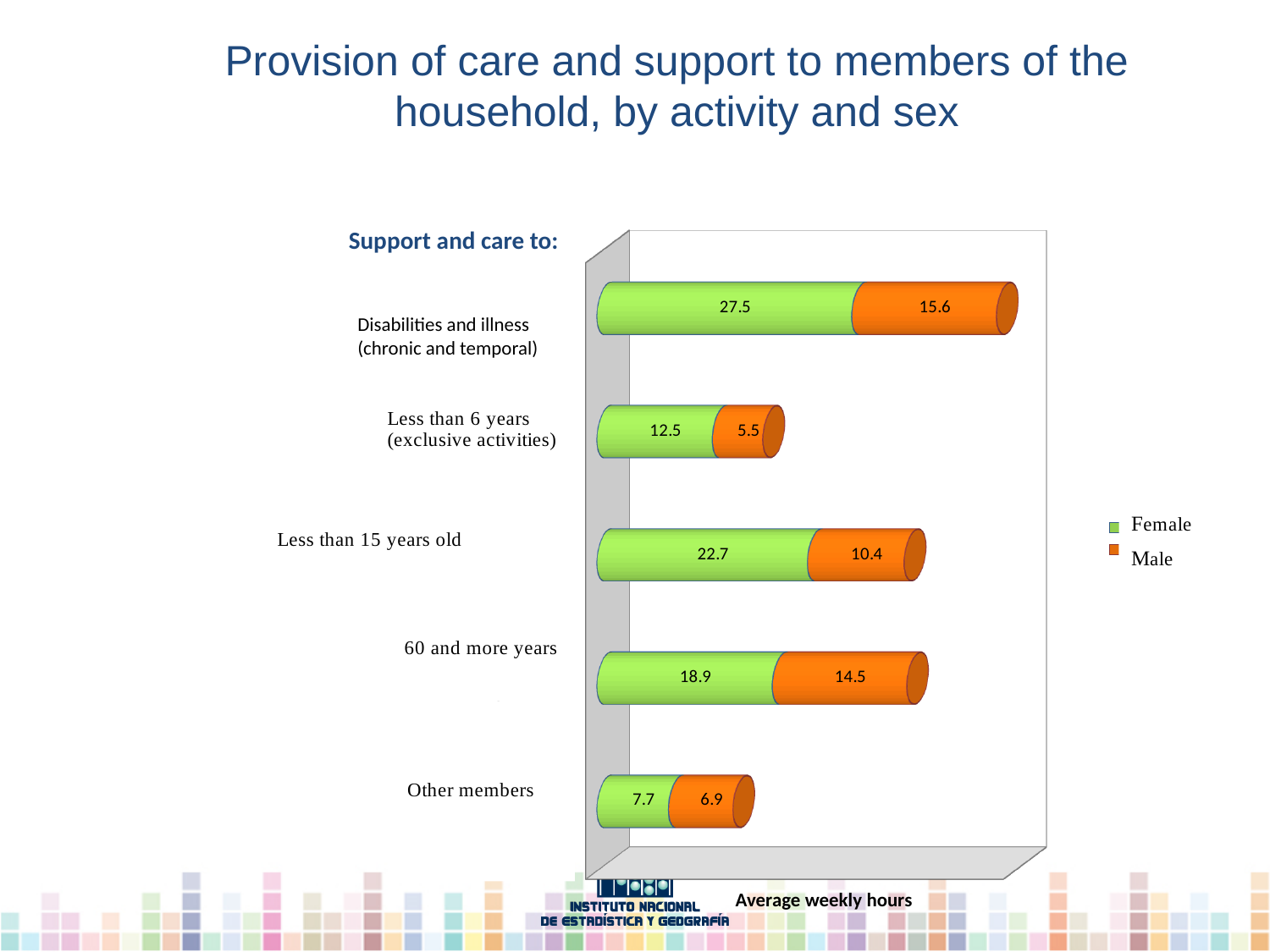
How many series does the legend list? 2 What is the Male value for 60 and more years? 14.5 How many categories are shown on the chart? 5 What is the Male value for Less than 6 years (exclusive activities)? 5.5 Which category has the highest Female value? Disabilities and illness (chronic and temporal) Which is larger, the Male value for 60 and more years or the Male value for Less than 15 years old? 60 and more years What is the difference between the Female and Male values for Less than 15 years old? 12.3 What kind of chart is shown on the slide? Stacked bar chart Which category has the lowest Male value? Less than 6 years (exclusive activities) What unit is given for the values on the chart? Average weekly hours What is the total of the stacked bar for Other members? 14.6 What is the Female value for Disabilities and illness (chronic and temporal)? 27.5